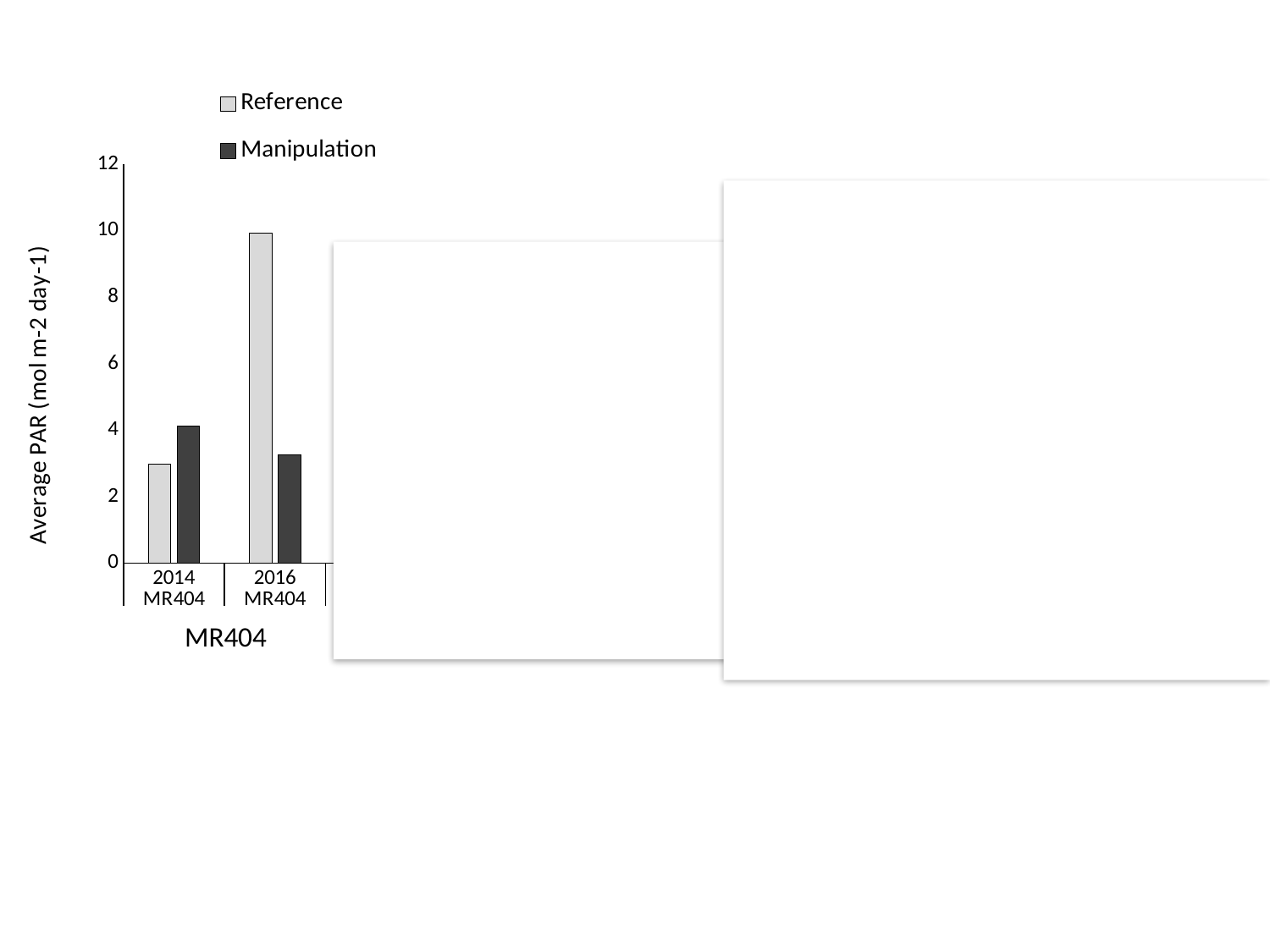
Does the Reference value rise or fall from 2014 MR404 to 2016 MR404? rise For 2014 MR404, which is larger, the Reference or the Manipulation value? Manipulation Is the Reference value for 2016 MR404 greater or less than 8? greater What are the two series named in the legend? Reference and Manipulation What kind of chart is shown on the slide? bar chart Is the Manipulation value for 2016 MR404 greater or less than 4? less For 2016 MR404, which is larger, the Reference or the Manipulation value? Reference Is the Reference value for 2014 MR404 greater or less than 4? less Which bar is the highest on the chart? Reference for 2016 MR404 How many series does the legend list? 2 What is the label on the vertical axis? Average PAR (mol m-2 day-1)